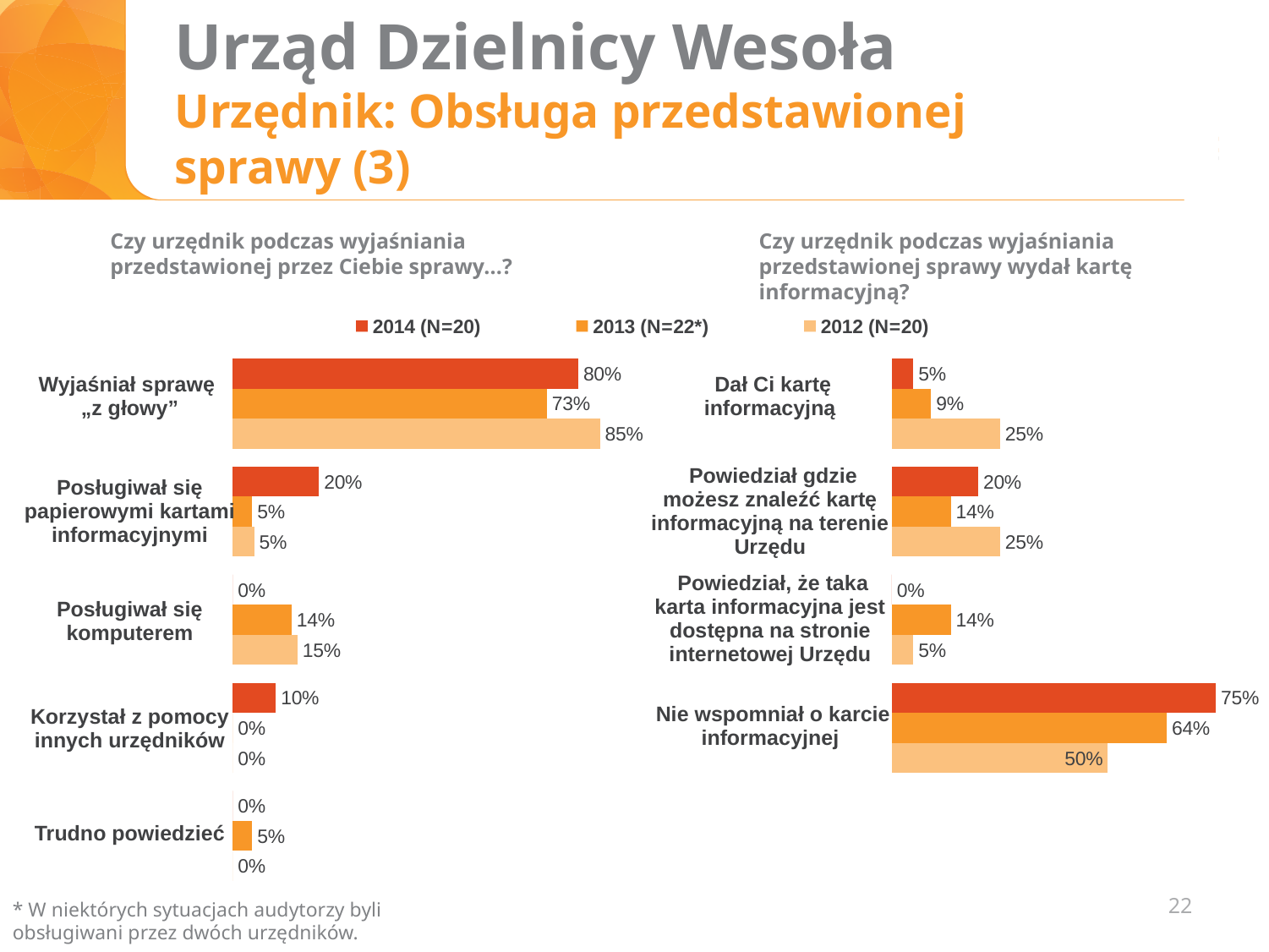
In the right chart, what is the difference between the 2014 and 2012 values for "Nie wspomniał o karcie informacyjnej"? 25% In the right chart ("Czy urzędnik podczas wyjaśniania przedstawionej sprawy wydał kartę informacyjną?"), what is the 2014 (N=20) value for "Nie wspomniał o karcie informacyjnej"? 75% How many series does the legend list? 3 In the left chart, what is the difference between the 2012 and 2013 values for "Wyjaśniał sprawę „z głowy”"? 12% In the right chart, what is the 2013 (N=22*) value for "Dał Ci kartę informacyjną"? 9% In the right chart, which is larger for "Powiedział gdzie możesz znaleźć kartę informacyjną na terenie Urzędu": the 2014 value or the 2012 value? 2012 What type of chart is used on this slide? Bar chart In the left chart, which category has the highest 2012 (N=20) value? Wyjaśniał sprawę „z głowy” In the left chart, what is the 2013 (N=22*) value for "Trudno powiedzieć"? 5% In the left chart, how many categories are shown? 5 In the left chart, what is the 2012 (N=20) value for "Posługiwał się komputerem"? 15% In the left chart ("Czy urzędnik podczas wyjaśniania przedstawionej przez Ciebie sprawy...?"), what is the 2014 (N=20) value for "Wyjaśniał sprawę „z głowy”"? 80%